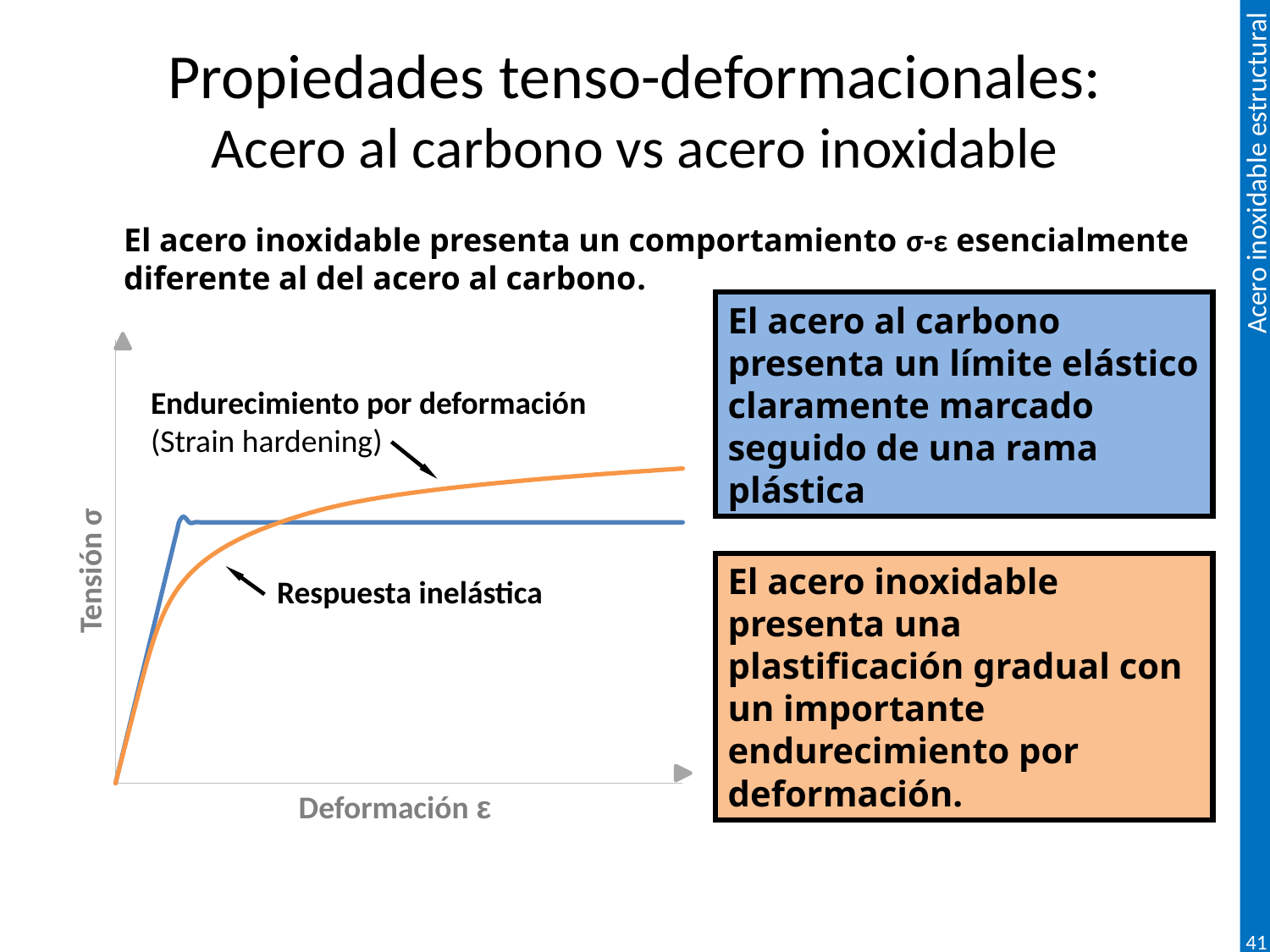
Near the origin, which curve rises more steeply, the blue one or the orange one? The blue one How many curves are plotted on the chart? 2 What kind of chart is shown on the slide? Line chart What is the label of the horizontal axis of the chart? Deformación ε At the right end of the chart, which curve reaches a higher stress value, the blue one or the orange one? The orange one Which curve does the annotation 'Endurecimiento por deformación (Strain hardening)' point to, the blue or the orange one? The orange one After its initial peak, does the blue curve rise, fall or stay flat as strain increases? Stays flat What is the label of the vertical axis of the chart? Tensión σ Does the orange curve rise or fall as strain increases along the x axis? Rises